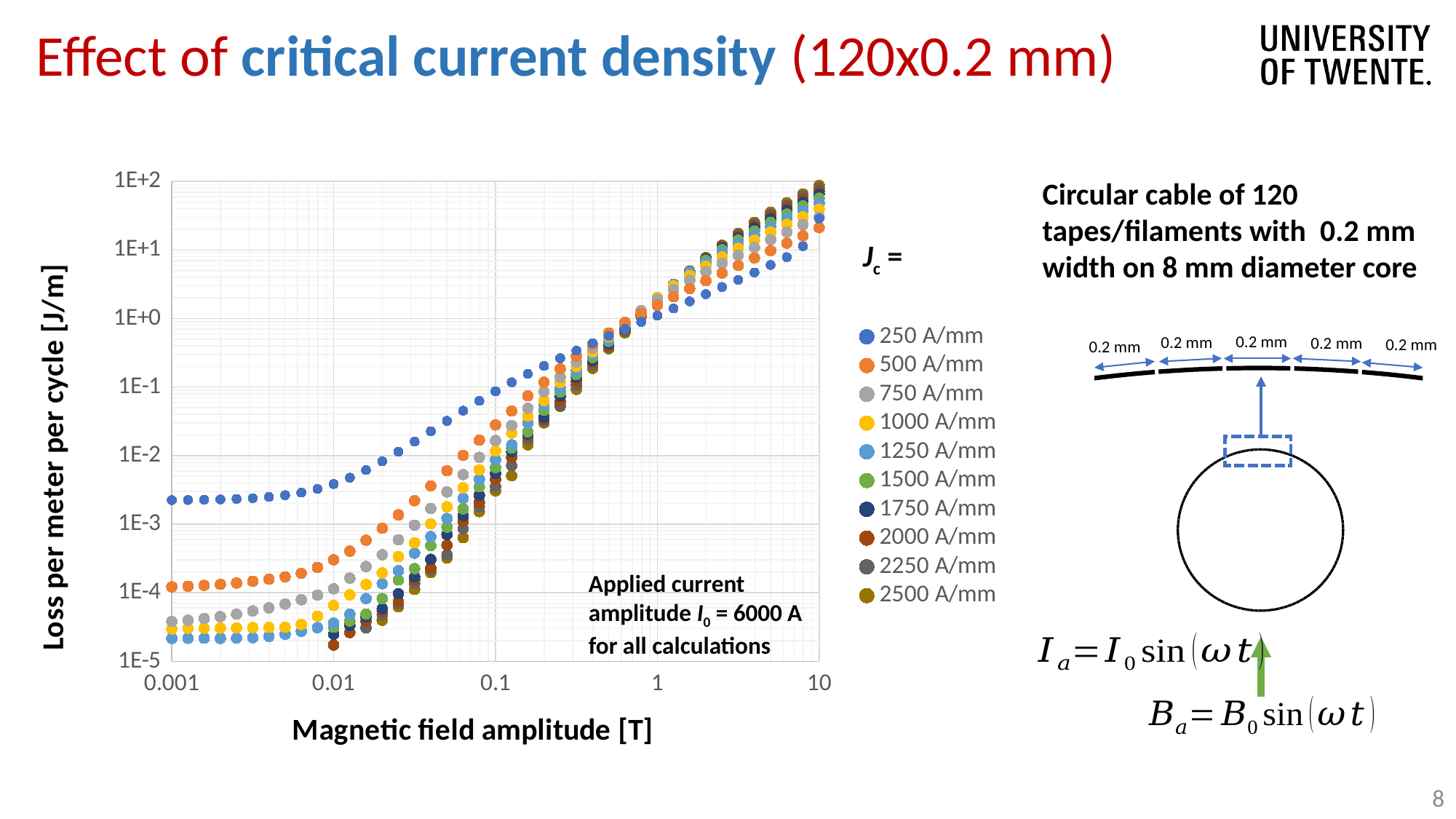
Which series has the lowest loss at a magnetic field amplitude of 10 T? 500 A/mm Is the loss for the 250 A/mm series at 0.01 T greater or less than 1E-3 J/m? greater Is the loss for the 250 A/mm series at 0.001 T greater or less than 1E-3 J/m? greater What is the label of the x axis of the chart? Magnetic field amplitude [T] At 0.001 T, which series has the larger loss: 250 A/mm or 500 A/mm? 250 A/mm At 0.01 T, which series has the larger loss: 500 A/mm or 2500 A/mm? 500 A/mm What is the label of the y axis of the chart? Loss per meter per cycle [J/m] How many series does the chart legend list? 10 What kind of chart is shown on the slide? scatter chart Is the loss for the 750 A/mm series at 0.001 T greater or less than 1E-4 J/m? less Which series has the highest loss at a magnetic field amplitude of 0.001 T? 250 A/mm Does the loss per meter per cycle rise or fall as the magnetic field amplitude increases? rise